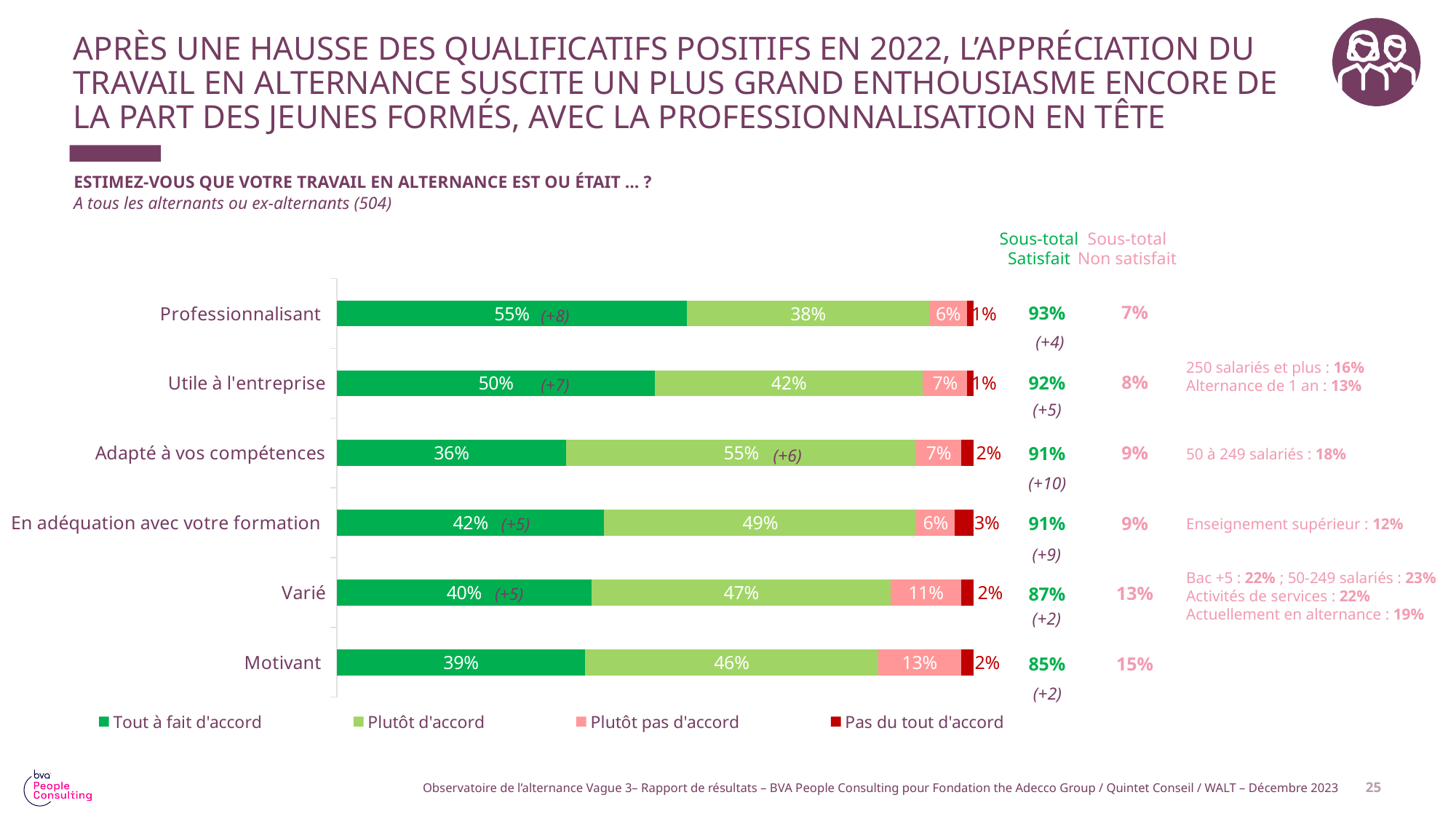
Which has a larger "Plutôt pas d'accord" share: "Varié" or "Utile à l'entreprise"? Varié What kind of chart is shown on the slide? Stacked horizontal bar chart What is the "Plutôt d'accord" value for "Adapté à vos compétences"? 55% Which category has the highest "Tout à fait d'accord" share? Professionnalisant What is the "Plutôt pas d'accord" value for "Motivant"? 13% What is the combined share of "Tout à fait d'accord" and "Plutôt d'accord" for "Varié"? 87% What percentage of respondents answered "Tout à fait d'accord" for "Professionnalisant"? 55% How many categories (qualifiers) are shown in the chart? 6 How many series does the legend list? 4 What is the difference between the "Tout à fait d'accord" values for "Professionnalisant" and "Motivant"? 16% What is the "Sous-total Non satisfait" value for "En adéquation avec votre formation"? 9% Which category has the lowest "Sous-total Satisfait"? Motivant